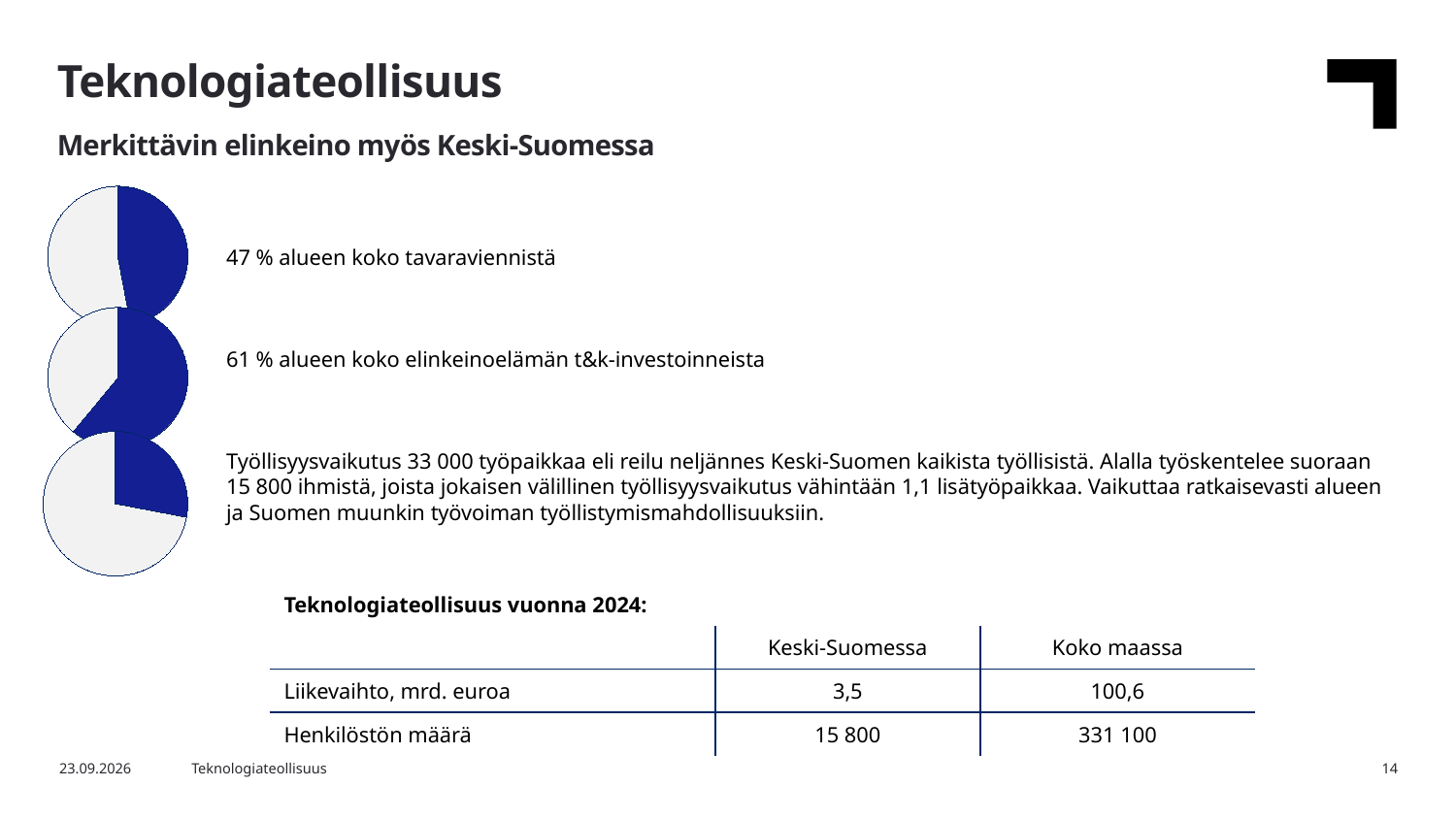
What colour is used for the highlighted slice in the pie charts? Blue How many pie charts are on the slide? 3 In the top pie chart, what share of the region's total goods exports (alueen koko tavaravienti) does the highlighted slice represent? 47 % Which pie chart has the larger highlighted slice, the top one or the middle one? The middle one Which of the three pie charts has the smallest highlighted slice? The bottom pie chart What kind of charts are shown on the left side of the slide? Pie charts Which of the three pie charts has the largest highlighted slice? The middle pie chart (61 %) Is the highlighted share in the bottom pie chart greater or less than 50 %? less By how many percentage points does the highlighted share in the middle pie chart (61 %) exceed that in the top pie chart (47 %)? 14 percentage points What does the top pie chart illustrate according to the text next to it? 47 % alueen koko tavaraviennistä Is the highlighted share in the middle pie chart greater or less than 50 %? greater In the middle pie chart, what share of the region's business R&D investments (elinkeinoelämän t&k-investoinnit) does the highlighted slice represent? 61 %